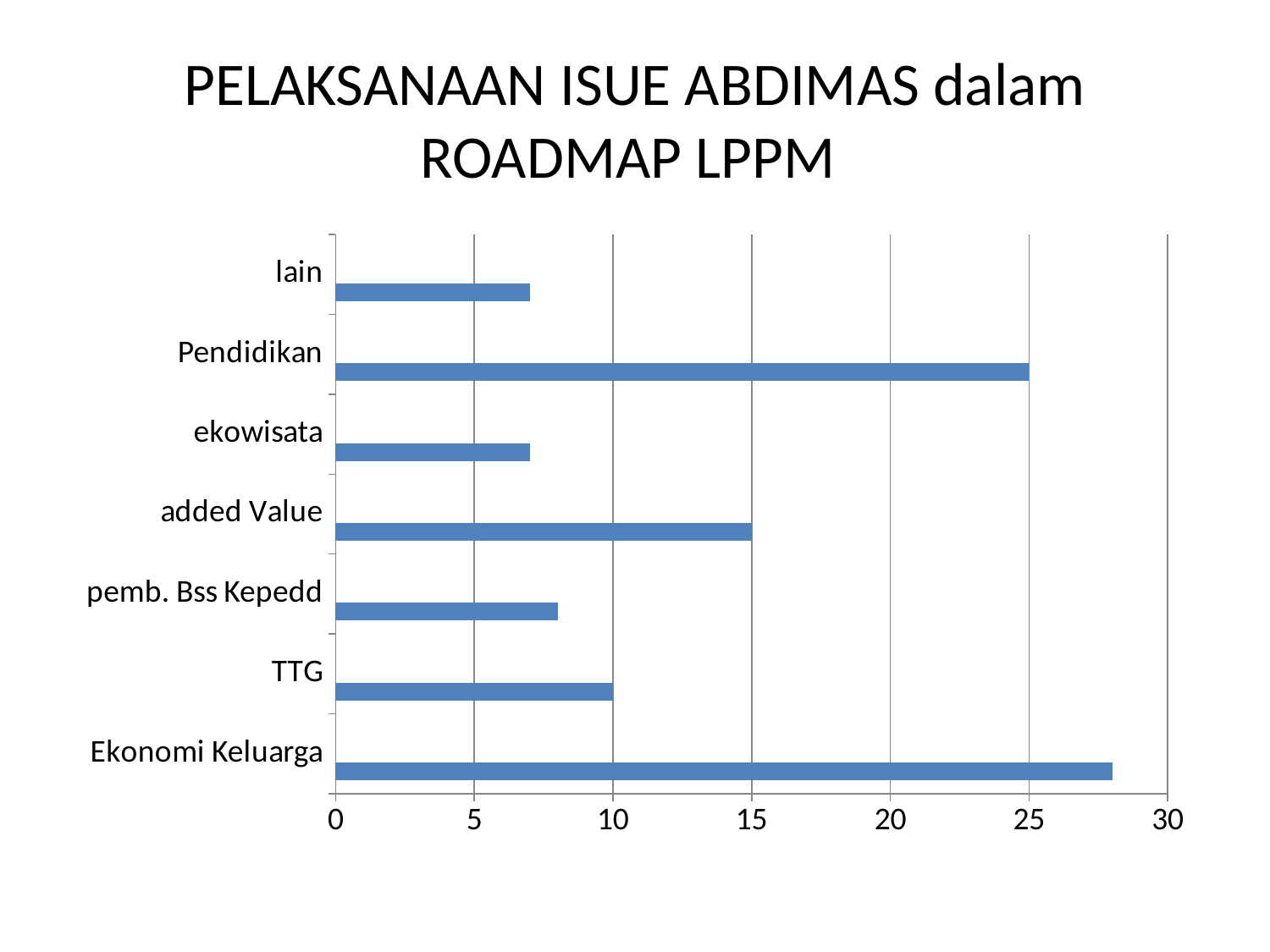
What is the difference between the values for Pendidikan and TTG? 15 What kind of chart is shown on the slide? bar chart Is the value for Ekonomi Keluarga greater or less than 25? greater What is the value for added Value? 15 Is the value for pemb. Bss Kepedd greater or less than 5? greater Which is larger, the value for Pendidikan or the value for added Value? Pendidikan What is the value for Pendidikan? 25 How many categories are shown in the chart? 7 What is the value for TTG? 10 What is the title of the chart? PELAKSANAAN ISUE ABDIMAS dalam ROADMAP LPPM Is the value for lain greater or less than 10? less Which category has the highest value? Ekonomi Keluarga